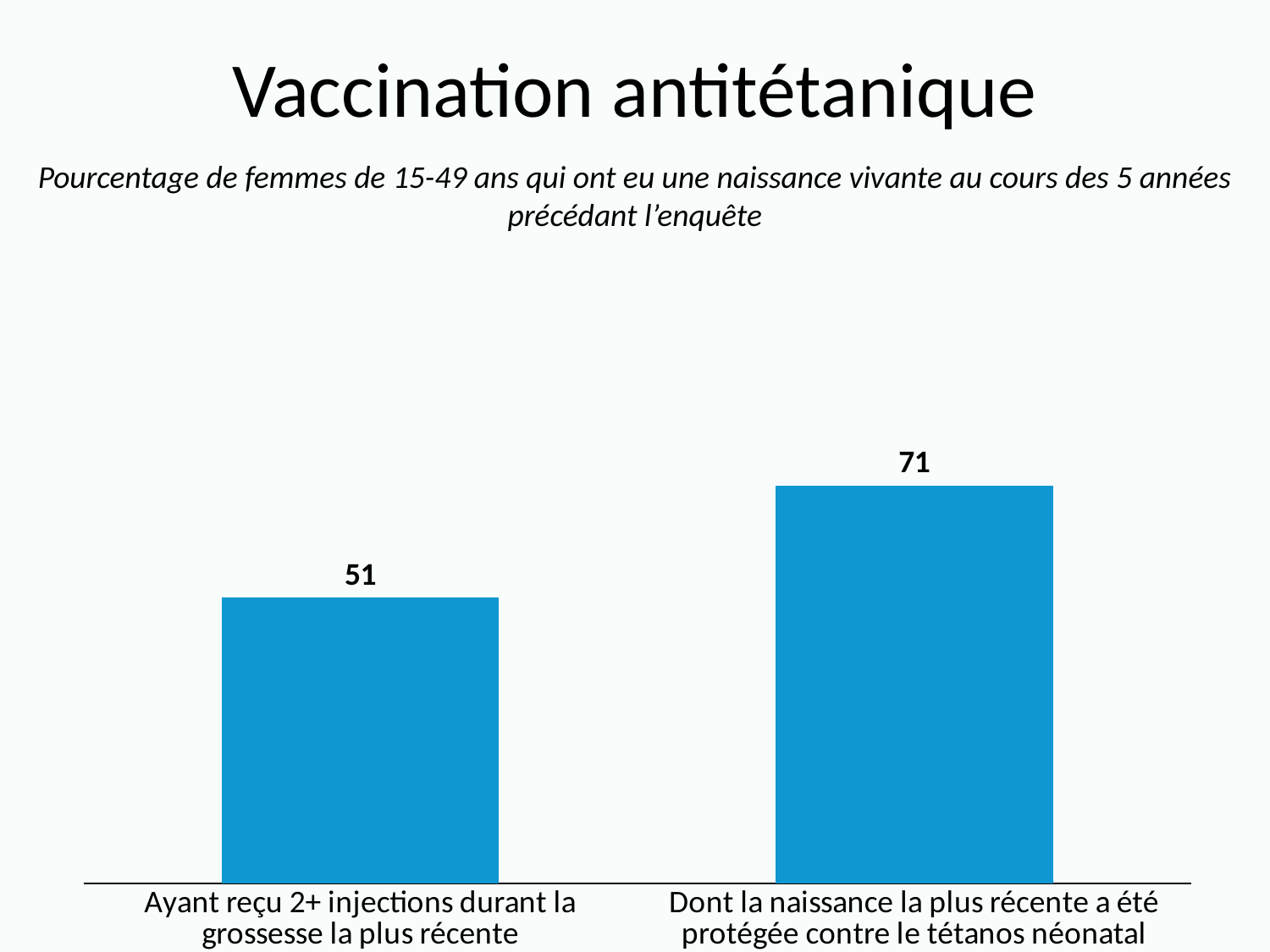
What is the title of the slide? Vaccination antitétanique Which category has the highest value? Dont la naissance la plus récente a été protégée contre le tétanos néonatal What is the difference between the value for 'Dont la naissance la plus récente a été protégée contre le tétanos néonatal' and the value for 'Ayant reçu 2+ injections durant la grossesse la plus récente'? 20 Do the values rise or fall from left to right across the categories? Rise Which category has the lowest value? Ayant reçu 2+ injections durant la grossesse la plus récente What is the value for 'Dont la naissance la plus récente a été protégée contre le tétanos néonatal'? 71 What is the value for 'Ayant reçu 2+ injections durant la grossesse la plus récente'? 51 Which is larger: the value for 'Ayant reçu 2+ injections durant la grossesse la plus récente' or the value for 'Dont la naissance la plus récente a été protégée contre le tétanos néonatal'? Dont la naissance la plus récente a été protégée contre le tétanos néonatal How many categories are shown in the chart? 2 What kind of chart is shown on the slide? Bar chart What colour are the bars in the chart? Blue